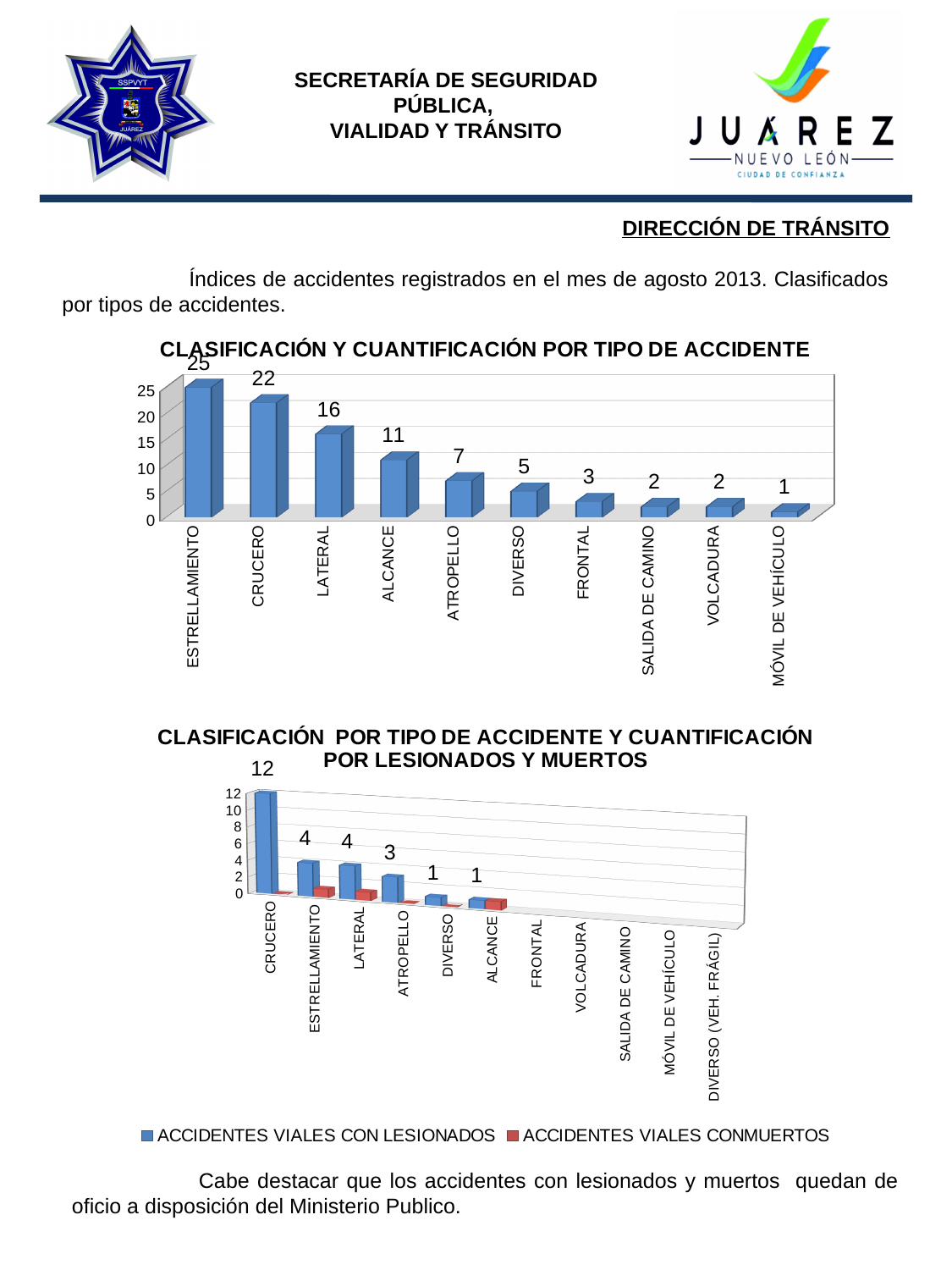
In the chart 'CLASIFICACIÓN Y CUANTIFICACIÓN POR TIPO DE ACCIDENTE', what is the value for ALCANCE? 11 In the chart 'CLASIFICACIÓN Y CUANTIFICACIÓN POR TIPO DE ACCIDENTE', which is larger, ATROPELLO or DIVERSO? ATROPELLO In the chart 'CLASIFICACIÓN Y CUANTIFICACIÓN POR TIPO DE ACCIDENTE', which category has the lowest value? MÓVIL DE VEHÍCULO What kind of chart is 'CLASIFICACIÓN POR TIPO DE ACCIDENTE Y CUANTIFICACIÓN POR LESIONADOS Y MUERTOS'? bar chart In the chart 'CLASIFICACIÓN Y CUANTIFICACIÓN POR TIPO DE ACCIDENTE', which category has the highest value? ESTRELLAMIENTO In the chart 'CLASIFICACIÓN Y CUANTIFICACIÓN POR TIPO DE ACCIDENTE', what is the value for ESTRELLAMIENTO? 25 In the chart 'CLASIFICACIÓN Y CUANTIFICACIÓN POR TIPO DE ACCIDENTE', what is the difference between CRUCERO and LATERAL? 6 Do the values in the chart 'CLASIFICACIÓN Y CUANTIFICACIÓN POR TIPO DE ACCIDENTE' rise or fall from left to right? fall In the chart 'CLASIFICACIÓN POR TIPO DE ACCIDENTE Y CUANTIFICACIÓN POR LESIONADOS Y MUERTOS', what is the value of ACCIDENTES VIALES CON LESIONADOS for CRUCERO? 12 In the chart 'CLASIFICACIÓN POR TIPO DE ACCIDENTE Y CUANTIFICACIÓN POR LESIONADOS Y MUERTOS', what is the value of ACCIDENTES VIALES CON LESIONADOS for ATROPELLO? 3 How many series does the legend list in the chart 'CLASIFICACIÓN POR TIPO DE ACCIDENTE Y CUANTIFICACIÓN POR LESIONADOS Y MUERTOS'? 2 How many categories are shown in the chart 'CLASIFICACIÓN Y CUANTIFICACIÓN POR TIPO DE ACCIDENTE'? 10